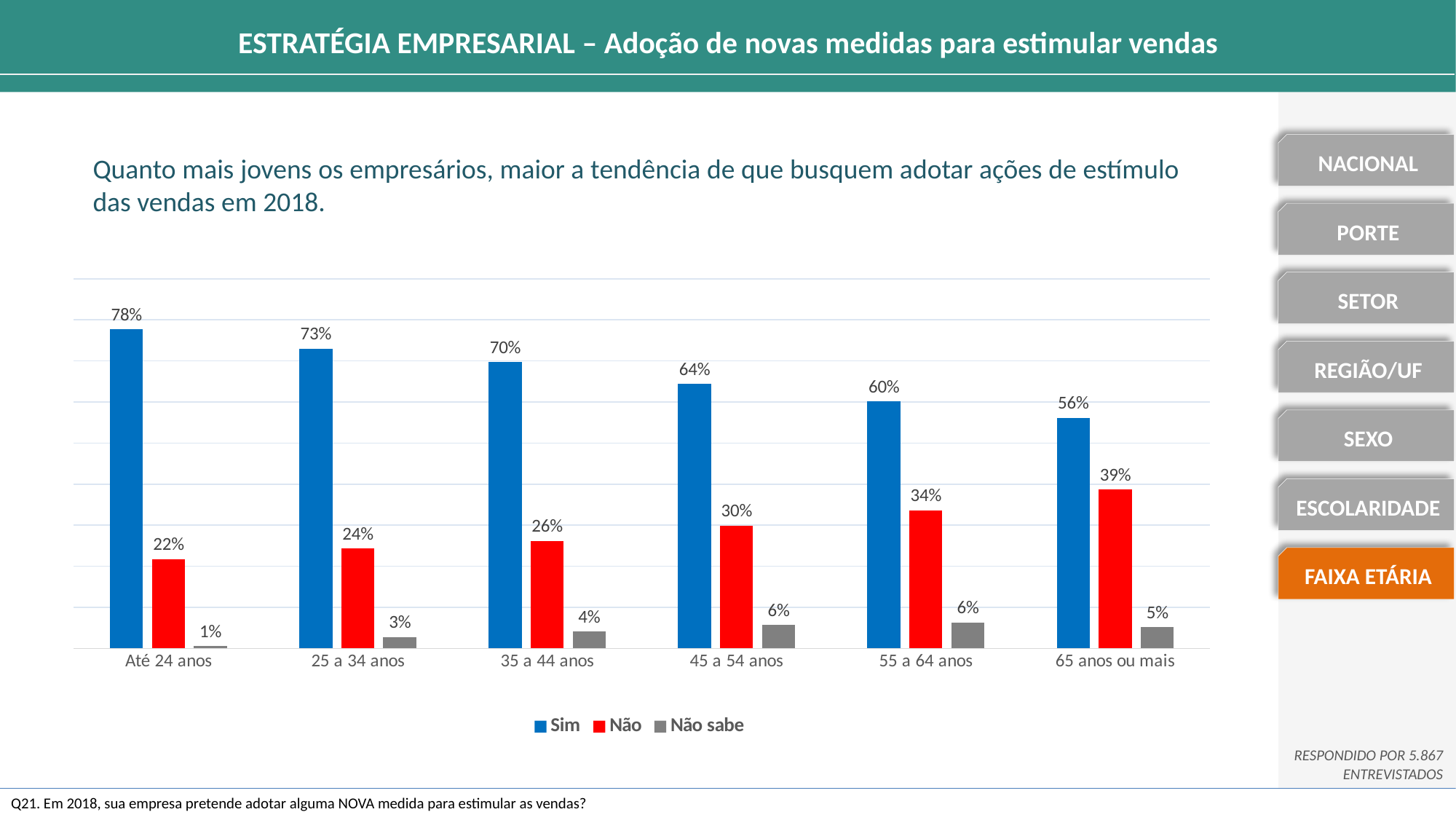
Which age group has the lowest "Não" value? Até 24 anos What is the value of "Sim" for the "Até 24 anos" age group? 78% What is the difference between the "Sim" values for "Até 24 anos" and "65 anos ou mais"? 22% Which age group has the highest "Sim" value? Até 24 anos How many age groups are shown on the x axis? 6 Does the "Sim" series rise or fall as the age groups get older along the x axis? Fall Which colour represents the "Não" series in the legend? Red What kind of chart is shown on the slide? Bar chart Which is larger: the "Não" value for "55 a 64 anos" or for "45 a 54 anos"? 55 a 64 anos How many series does the legend list? 3 What is the value of "Não" for the "65 anos ou mais" age group? 39% What is the value of "Não sabe" for the "45 a 54 anos" age group? 6%